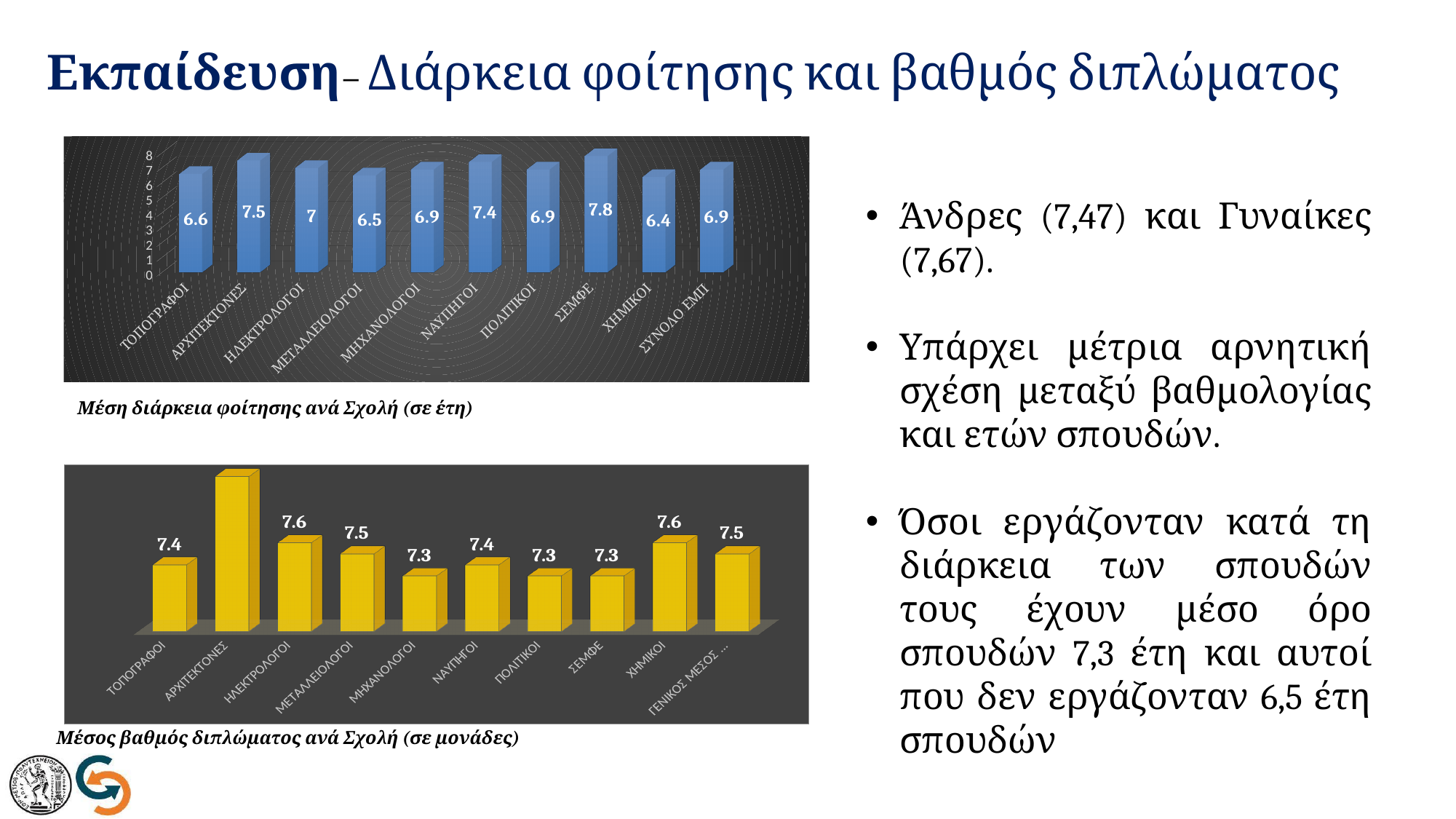
In the top chart (Μέση διάρκεια φοίτησης ανά Σχολή), which school has the highest value? ΣΕΜΦΕ How many bars are in the top chart (Μέση διάρκεια φοίτησης ανά Σχολή)? 10 In the top chart (Μέση διάρκεια φοίτησης ανά Σχολή), which is larger, ΝΑΥΠΗΓΟΙ or ΗΛΕΚΤΡΟΛΟΓΟΙ? ΝΑΥΠΗΓΟΙ What colour are the bars in the top chart (Μέση διάρκεια φοίτησης ανά Σχολή)? Blue In the bottom chart (Μέσος βαθμός διπλώματος ανά Σχολή), which school has the highest bar? ΑΡΧΙΤΕΚΤΟΝΕΣ In the top chart (Μέση διάρκεια φοίτησης ανά Σχολή), what is the value for ΣΕΜΦΕ? 7.8 In the bottom chart (Μέσος βαθμός διπλώματος ανά Σχολή), what is the difference between ΗΛΕΚΤΡΟΛΟΓΟΙ and ΜΗΧΑΝΟΛΟΓΟΙ? 0.3 In the top chart (Μέση διάρκεια φοίτησης ανά Σχολή), which school has the lowest value? ΧΗΜΙΚΟΙ In the top chart (Μέση διάρκεια φοίτησης ανά Σχολή), what is the value for ΣΥΝΟΛΟ ΕΜΠ? 6.9 In the bottom chart (Μέσος βαθμός διπλώματος ανά Σχολή), what is the value for ΧΗΜΙΚΟΙ? 7.6 What type of chart is the bottom chart (Μέσος βαθμός διπλώματος ανά Σχολή)? Bar chart In the top chart (Μέση διάρκεια φοίτησης ανά Σχολή), what is the difference between ΑΡΧΙΤΕΚΤΟΝΕΣ and ΜΕΤΑΛΛΕΙΟΛΟΓΟΙ? 1